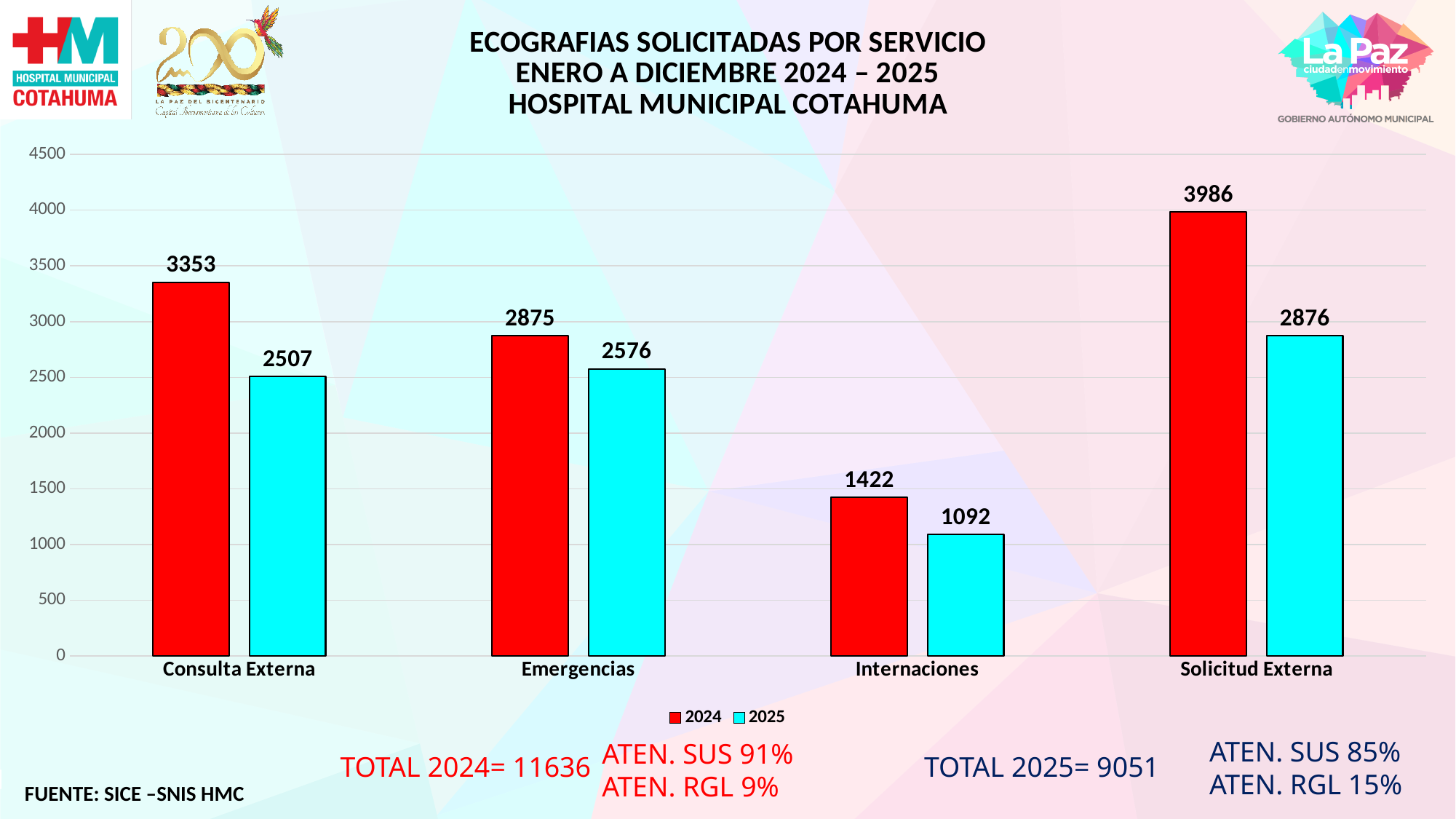
Which category has the lowest 2025 value? Internaciones How many categories are shown on the x axis? 4 What is the 2025 value for Internaciones? 1092 What is the difference between the 2024 and 2025 values for Consulta Externa? 846 What is the difference between the 2024 and 2025 values for Solicitud Externa? 1110 Which colour represents the 2025 series in the legend? Cyan What is the 2025 value for Solicitud Externa? 2876 Which category has the highest 2024 value? Solicitud Externa What is the 2024 value for Consulta Externa? 3353 How many series does the legend list? 2 Which is larger, the 2024 value for Emergencias or the 2025 value for Solicitud Externa? 2025 value for Solicitud Externa What kind of chart is shown on the slide? Bar chart